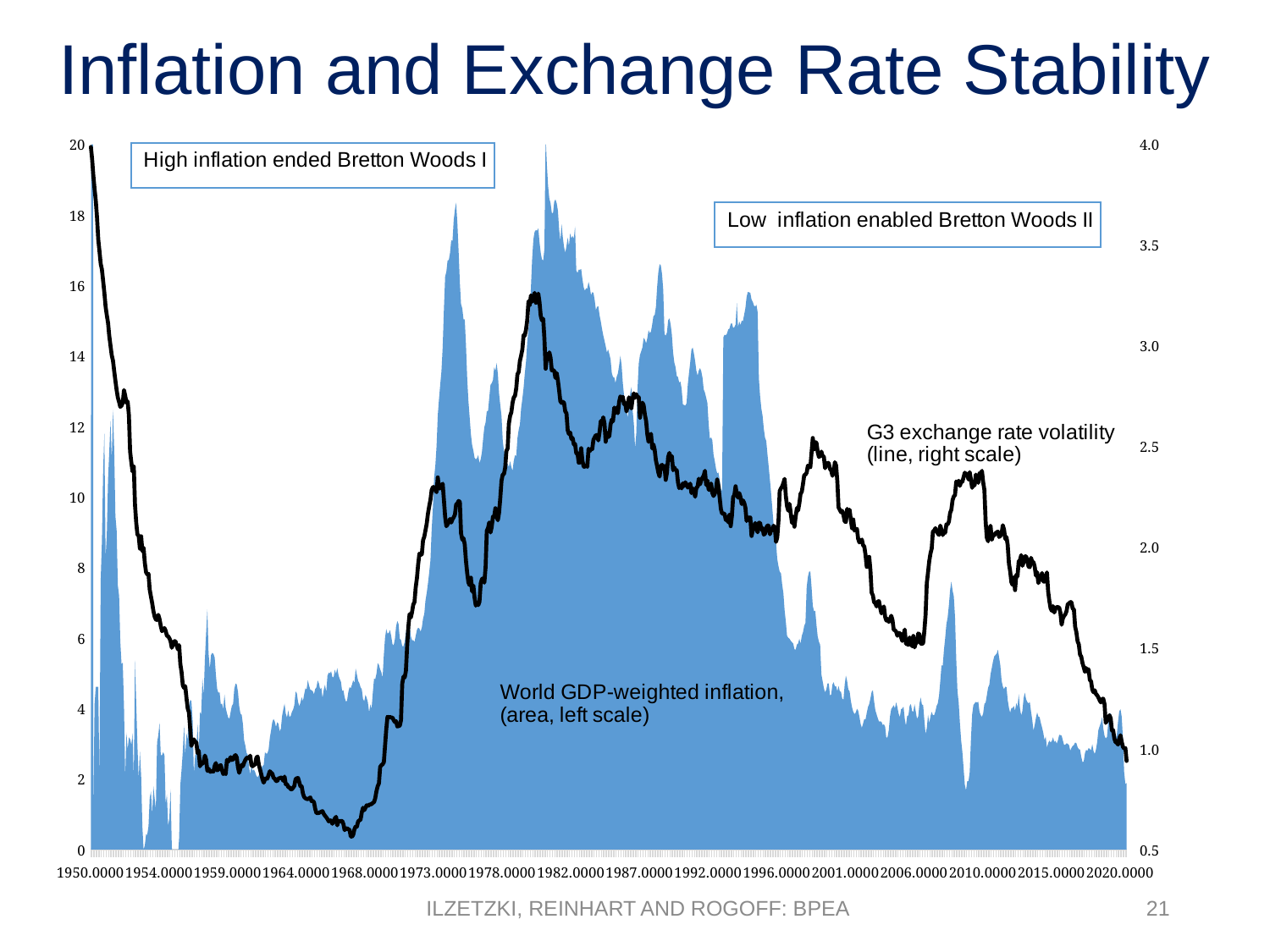
Is the value of G3 exchange rate volatility around 1968 greater or less than 1.0 on the right scale? less What is the title of the slide? Inflation and Exchange Rate Stability Is the value of G3 exchange rate volatility at the start of the series (1950) greater or less than 3.5 on the right scale? greater Does G3 exchange rate volatility rise or fall between 2010 and 2020? fall Is the value of G3 exchange rate volatility at the end of the series (around 2020) greater or less than 1.5 on the right scale? less How many data series are plotted on the chart? 2 Which series is plotted as the shaded area on the left scale? World GDP-weighted inflation Does World GDP-weighted inflation rise or fall between 1968 and 1980? rise What kind of chart is shown on the slide? A combination chart with an area series and a line series Does G3 exchange rate volatility rise or fall between 1950 and 1968? fall